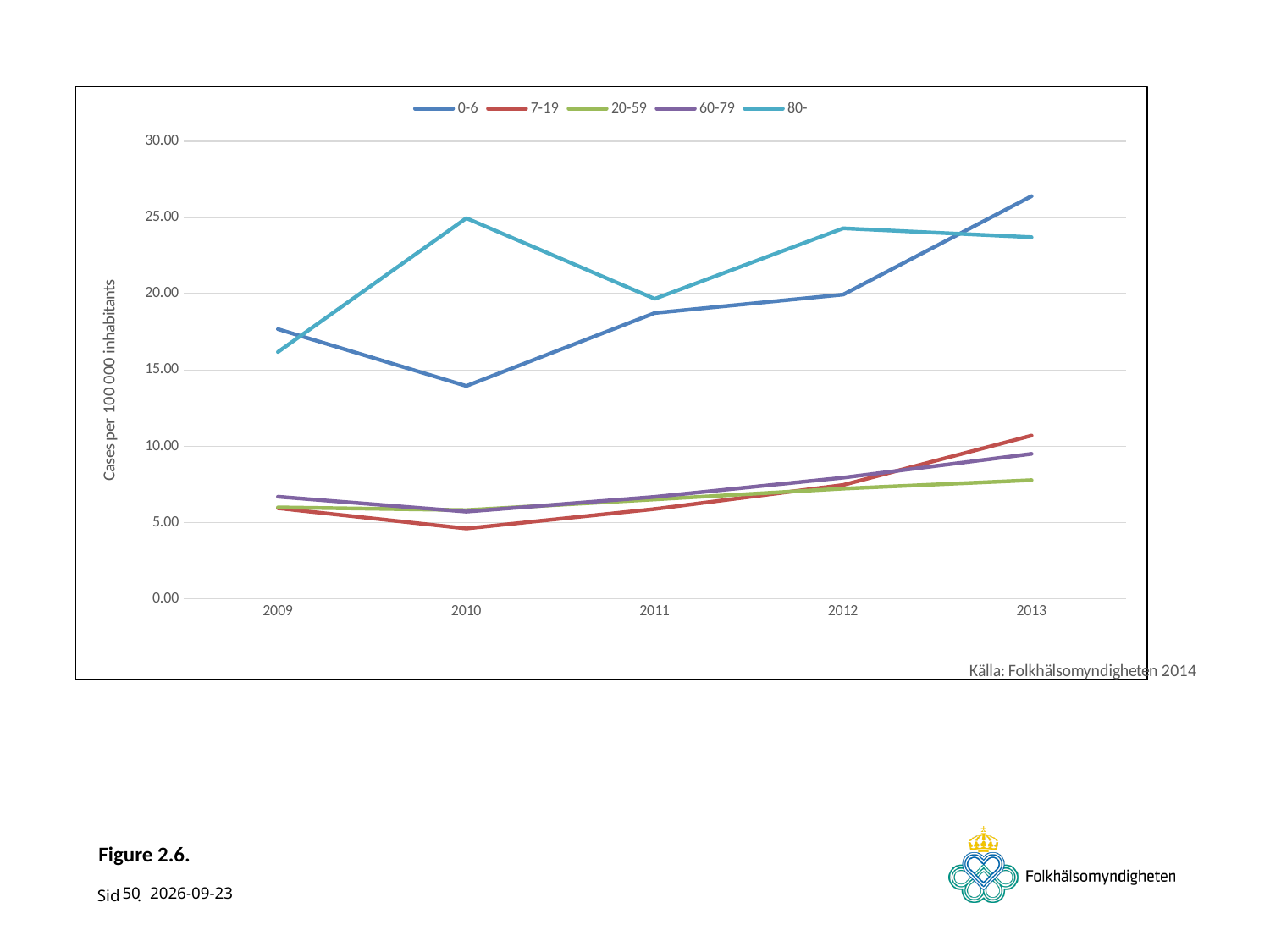
What kind of chart is shown on the slide? line chart Is the value for the 0-6 series in 2013 greater or less than 25.00? greater Is the value for the 80- series in 2010 greater or less than 20.00? greater Which series has the lowest value in 2010? 7-19 How many series does the legend list? 5 Is the value for the 7-19 series in 2010 greater or less than 5.00? less How many years are shown along the x axis? 5 Which series has the highest value in 2013? 0-6 In 2013, which series has the larger value, 0-6 or 80-? 0-6 Does the 7-19 series rise or fall from 2010 to 2013? rise In 2010, which series has the larger value, 80- or 0-6? 80-